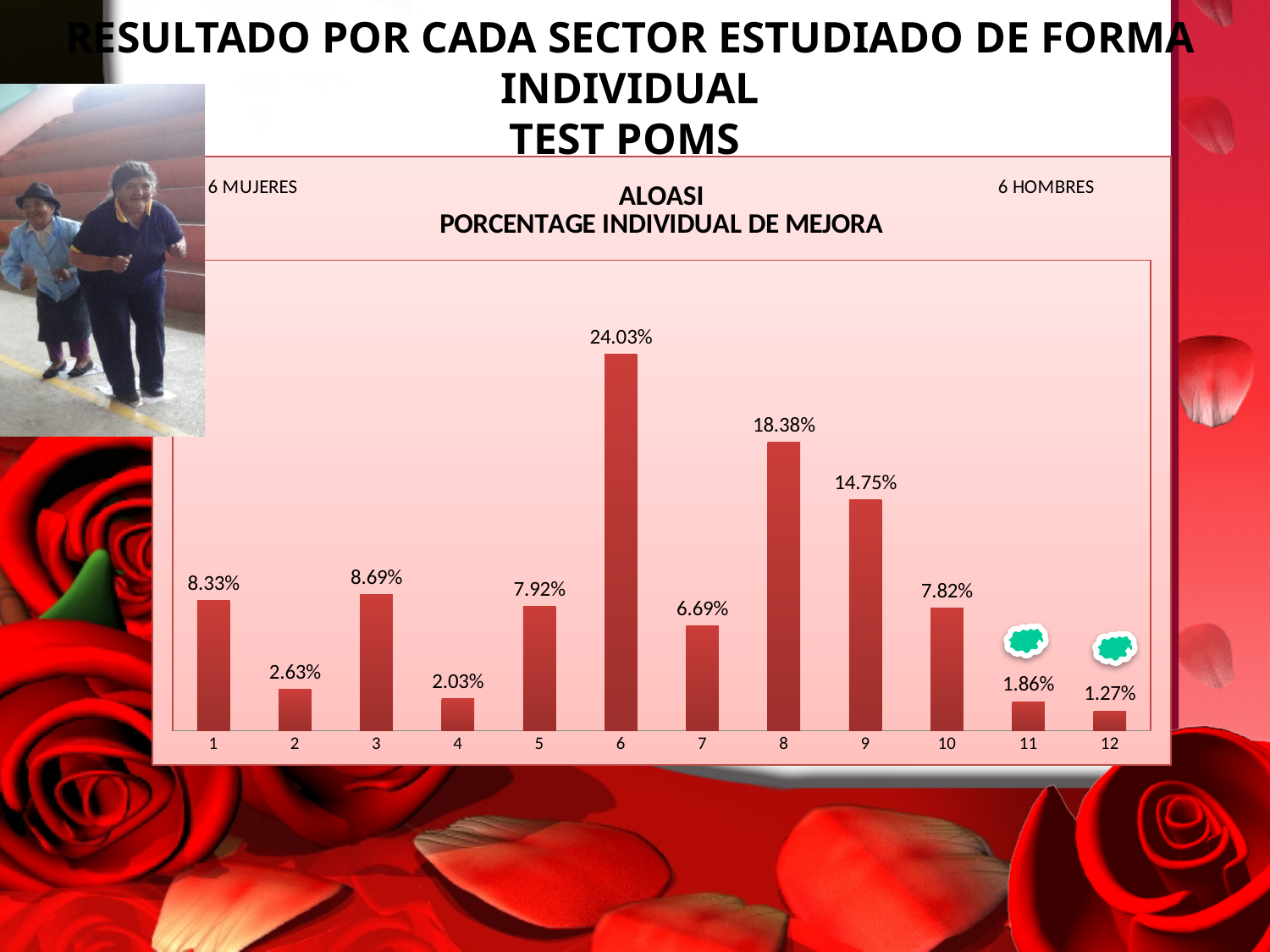
How many categories are shown on the x axis? 12 What is the value for category 10? 7.82% What is the title of the chart? ALOASI PORCENTAGE INDIVIDUAL DE MEJORA What kind of chart is shown? bar chart What is the difference between the values for category 2 and category 4? 0.60% Which is larger, the value for category 3 or the value for category 5? 3 What is the value for category 12? 1.27% What is the value for category 6? 24.03% What is the value for category 1? 8.33% Which category has the lowest value? 12 What is the difference between the values for category 8 and category 9? 3.63% Which category has the highest value? 6